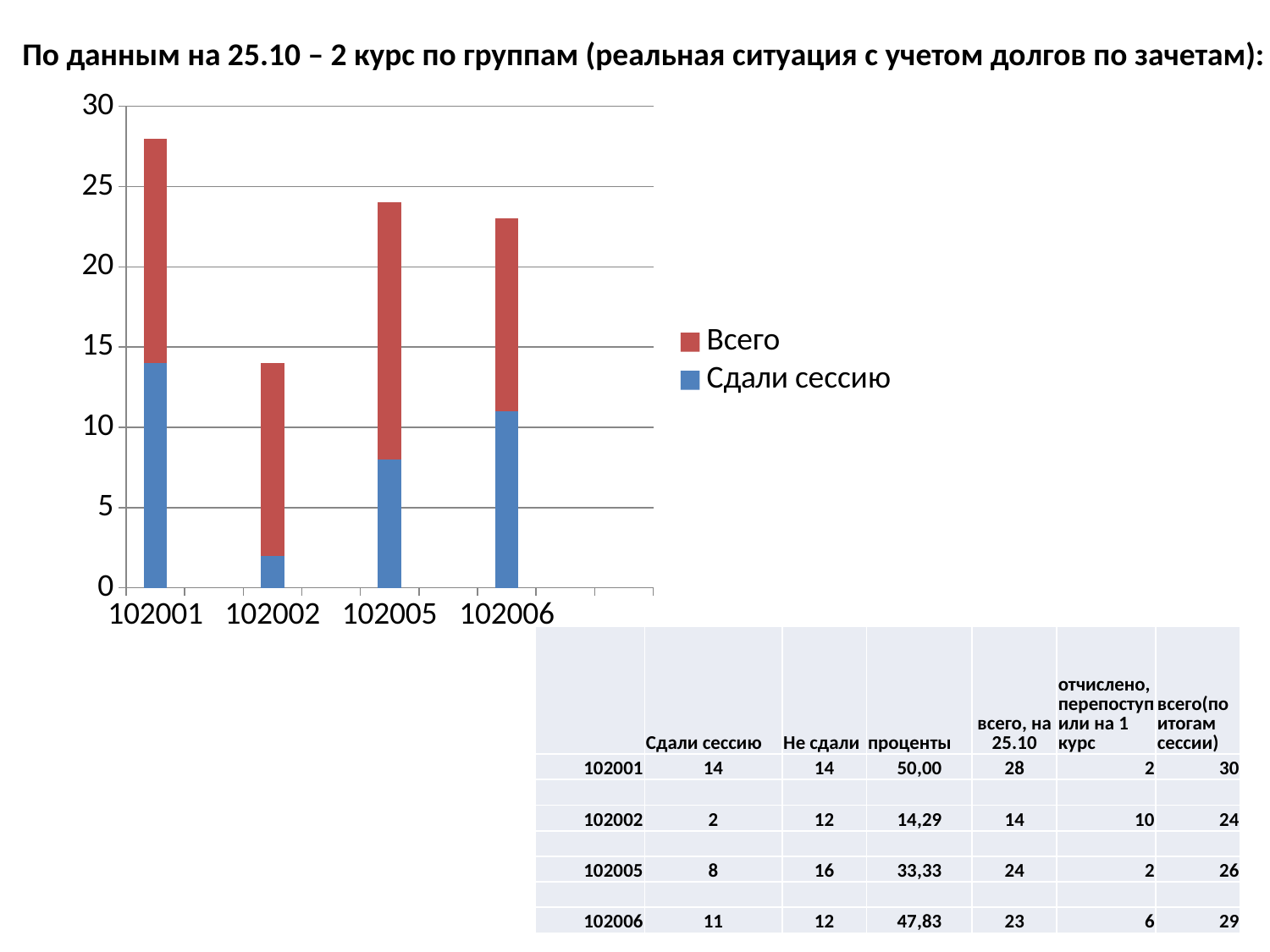
How many groups are shown on the x axis of the chart? 4 What is the value of 'Сдали сессию' for group 102002? 2 How many series does the chart legend list? 2 What is the difference between the 'Сдали сессию' values of groups 102001 and 102002? 12 Which group has the tallest stacked bar in the chart? 102001 Is the total height of the stacked bar for group 102005 greater or less than 20? greater Which group has the larger 'Сдали сессию' value, 102005 or 102006? 102006 Is the 'Сдали сессию' value for group 102006 greater or less than 10? greater What kind of chart is shown on the slide? Stacked bar chart Which group has the shortest stacked bar in the chart? 102002 Which colour represents the 'Сдали сессию' series in the chart? Blue What is the value of 'Сдали сессию' for group 102001? 14